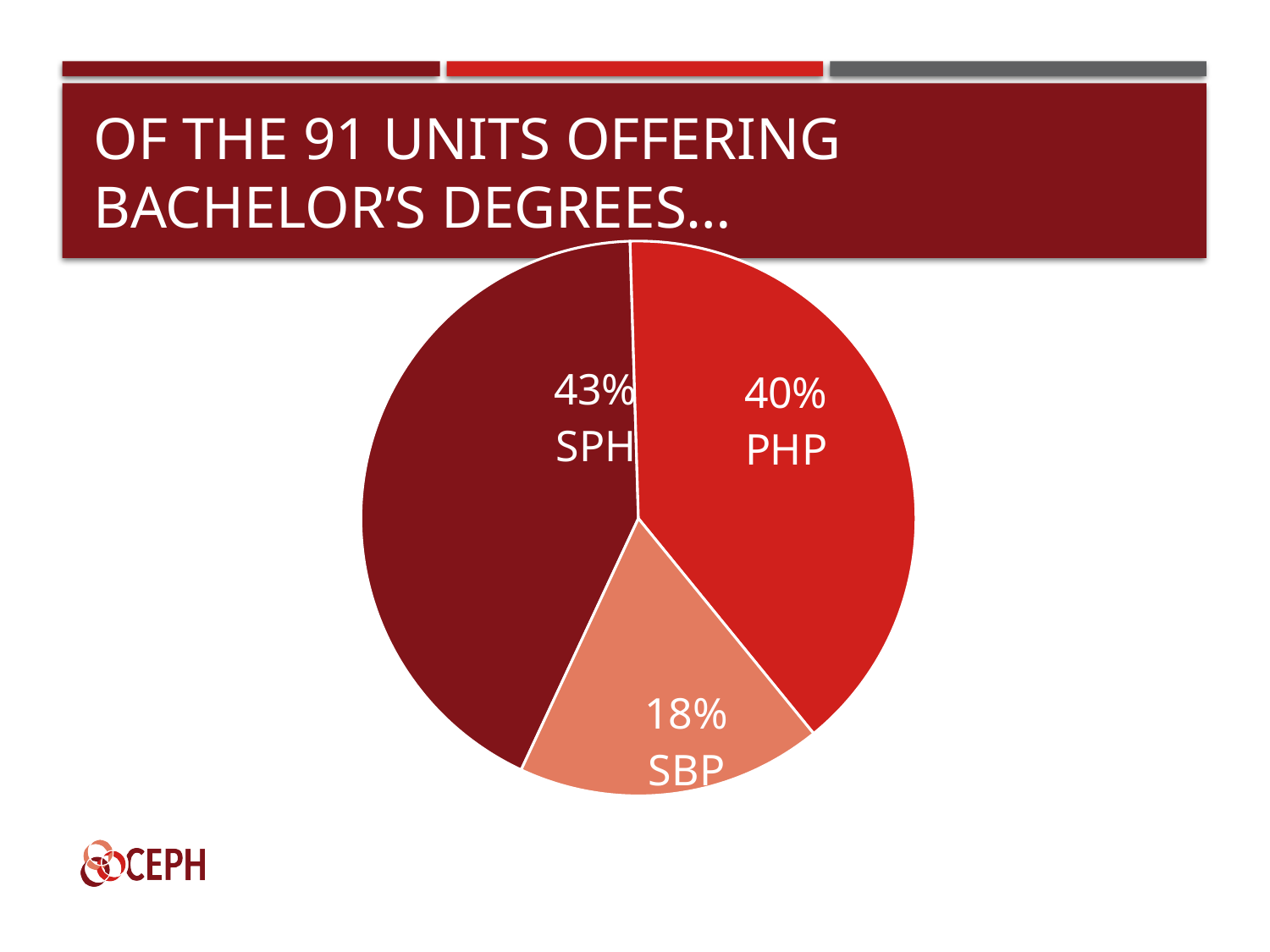
What kind of chart is shown on the slide? Pie chart What share of the pie does PHP represent? 40% Which is larger, the PHP slice or the SBP slice? PHP What share of the pie does SPH represent? 43% Which slice is shown in the lightest colour? SBP What is the difference in percentage points between the SPH and SBP slices? 25 Which category has the largest slice of the pie? SPH How many units offering bachelor's degrees does the slide title refer to? 91 What is the difference in percentage points between the PHP and SBP slices? 22 What share of the pie does SBP represent? 18% Which category has the smallest slice of the pie? SBP How many slices does the pie chart have? 3